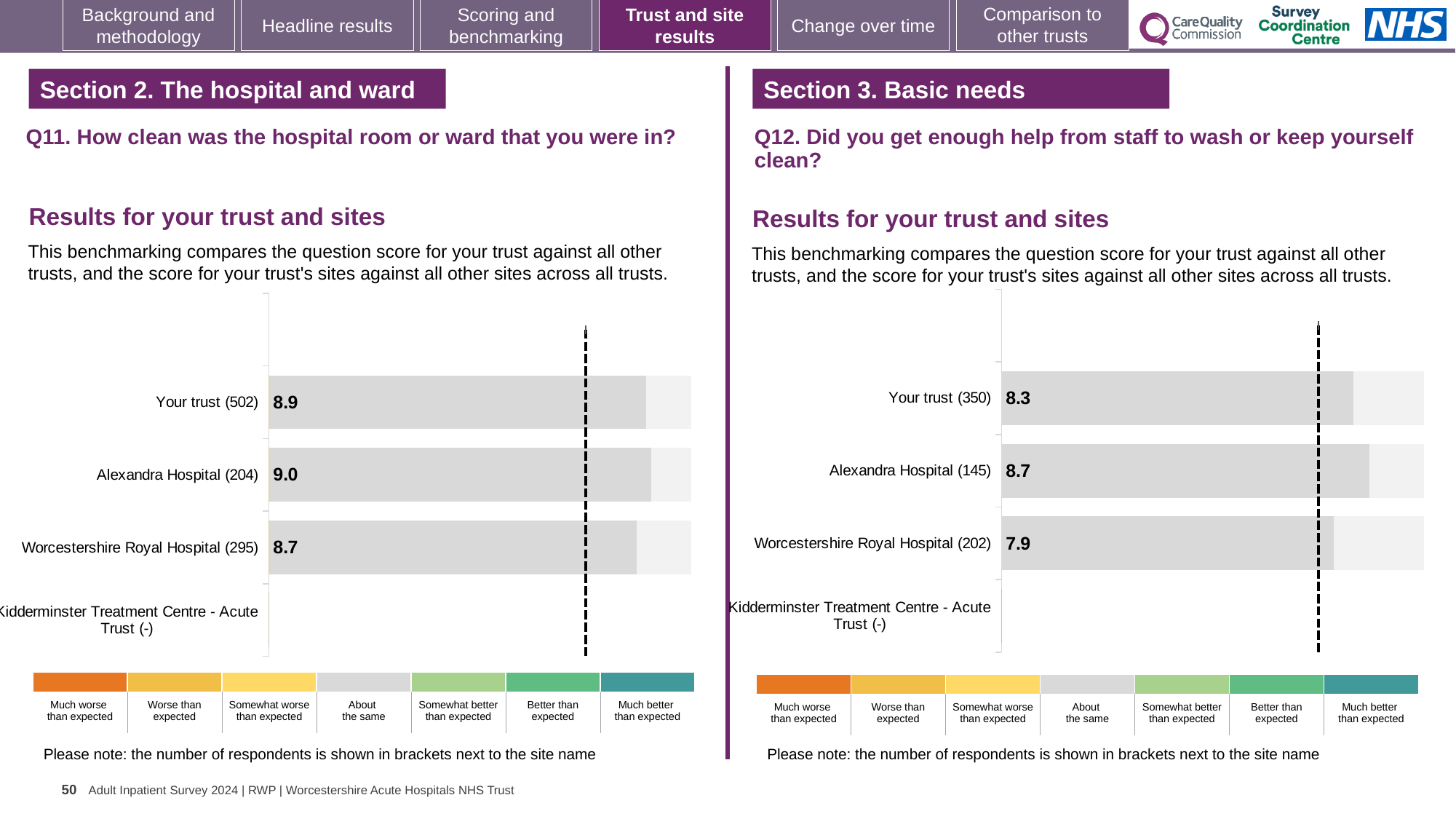
In the Q11 chart (left), what is the score for Your trust? 8.9 In the Q12 chart (right), what is the score for Worcestershire Royal Hospital? 7.9 What kind of chart is used on the left for Q11? Bar chart In the Q11 chart (left), which has the higher score, Your trust or Worcestershire Royal Hospital? Your trust In the Q11 chart (left), what is the score for Worcestershire Royal Hospital? 8.7 In the Q12 chart (right), which site has the lowest score? Worcestershire Royal Hospital In the Q12 chart (right), what is the difference between the scores for Alexandra Hospital and Worcestershire Royal Hospital? 0.8 In the Q11 chart (left), what is the score for Alexandra Hospital? 9.0 In the Q12 chart (right), what is the score for Your trust? 8.3 In the Q11 chart (left), what is the difference between the scores for Alexandra Hospital and Worcestershire Royal Hospital? 0.3 In the Q12 chart (right), which site has the highest score? Alexandra Hospital In the Q12 chart (right), how many respondents are shown in brackets for Alexandra Hospital? 145